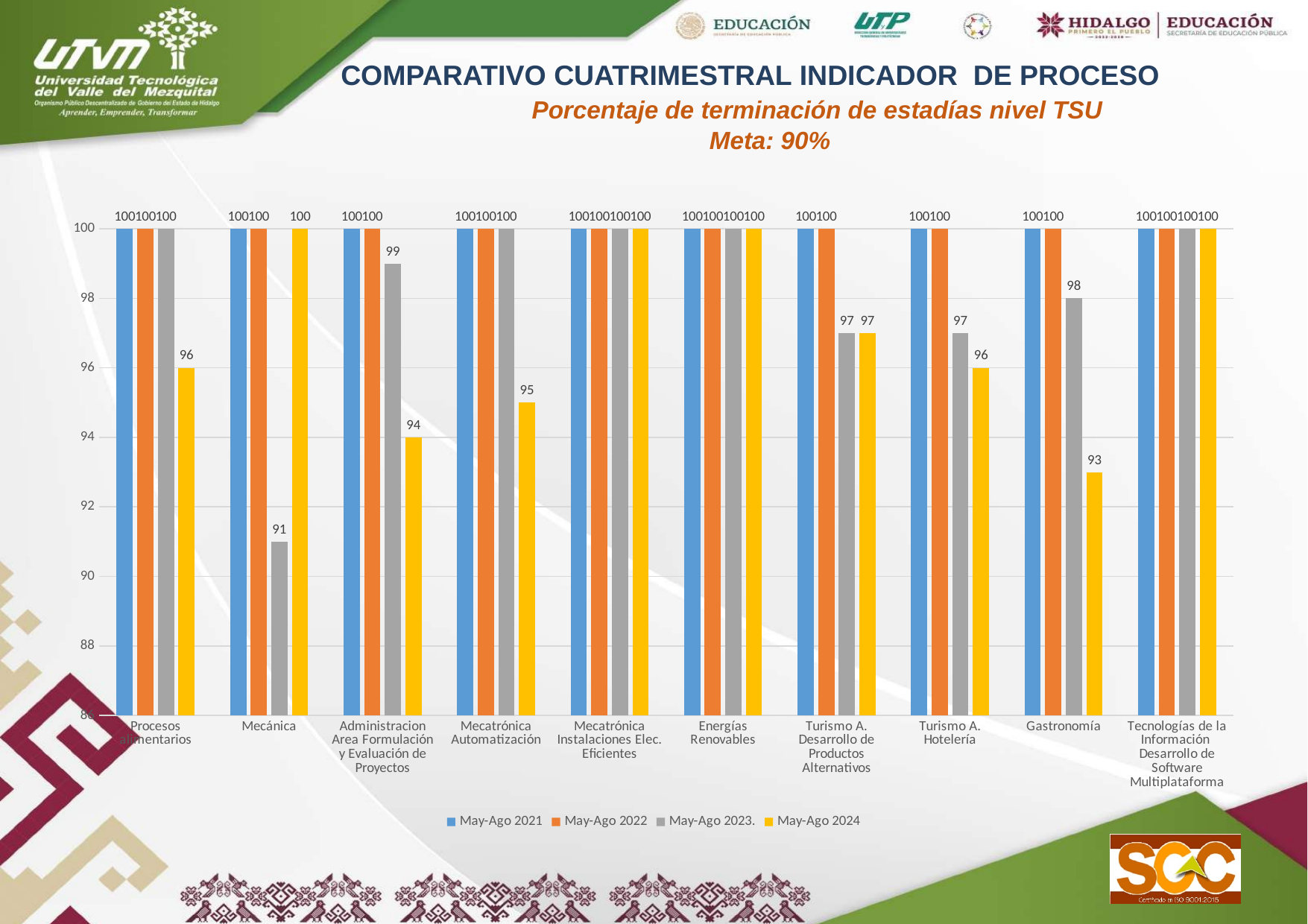
How many categories (programs) are shown on the x axis? 10 What is the difference between the May-Ago 2023 and May-Ago 2024 values for Gastronomía? 5 What kind of chart is shown on the slide? bar chart What is the May-Ago 2024 value for Turismo A. Hotelería? 96 What is the May-Ago 2023 value for Mecánica? 91 How many series does the legend list? 4 Is the May-Ago 2023 value for Mecánica greater or less than 92? less Which category has the lowest May-Ago 2023 value? Mecánica What target (Meta) is stated in the chart subtitle? 90% Which is larger: the May-Ago 2024 value for Administracion Area Formulación y Evaluación de Proyectos or for Mecatrónica Automatización? Mecatrónica Automatización Which category has the lowest May-Ago 2024 value? Gastronomía What is the May-Ago 2024 value for Gastronomía? 93